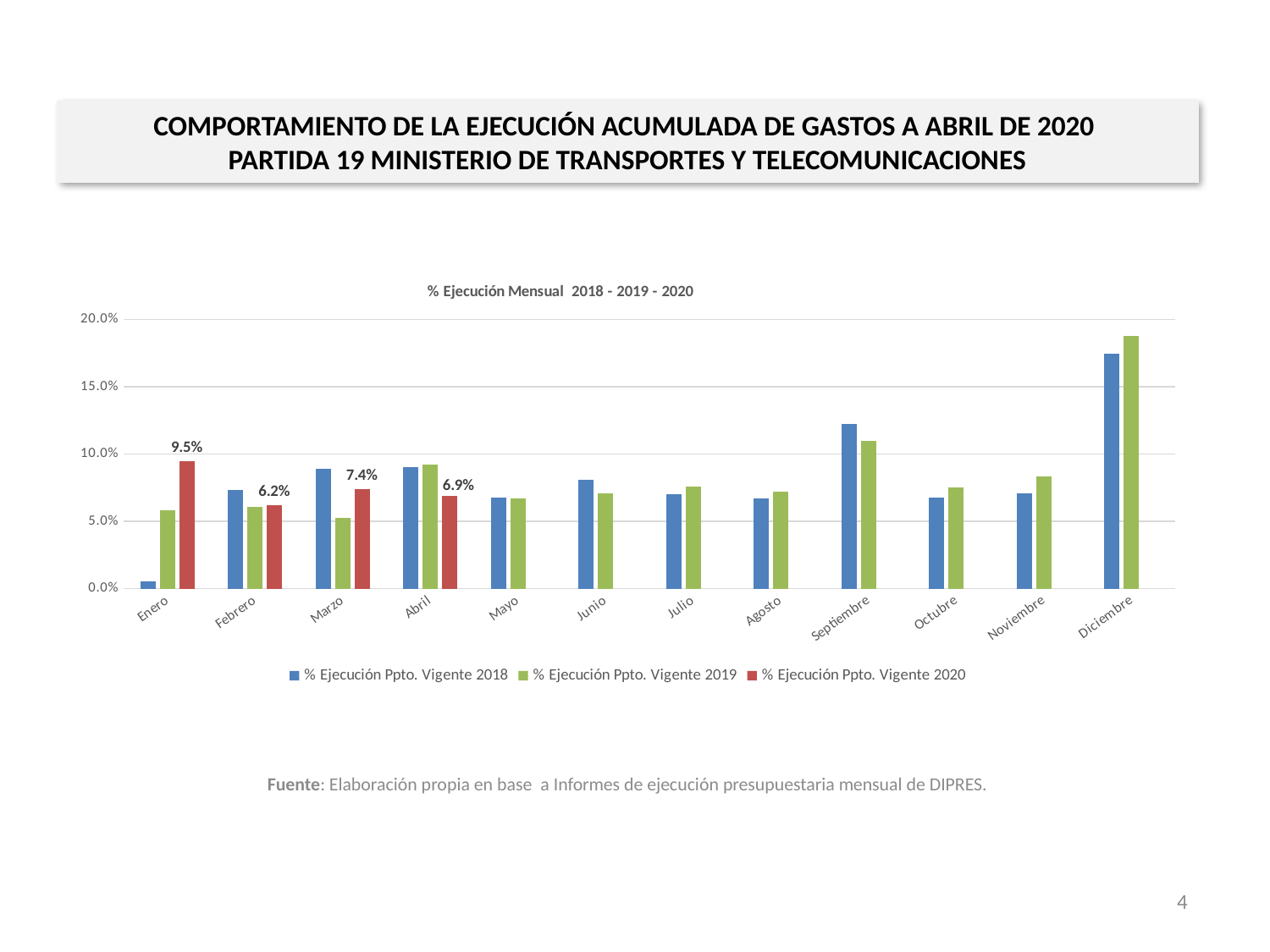
What is the value for Marzo in the % Ejecución Ppto. Vigente 2020 series? 7.4% In the % Ejecución Ppto. Vigente 2020 series, which is larger, the value for Marzo or the value for Abril? Marzo What is the value for Abril in the % Ejecución Ppto. Vigente 2020 series? 6.9% Which month has the lowest value in the % Ejecución Ppto. Vigente 2020 series? Febrero What is the value for Enero in the % Ejecución Ppto. Vigente 2020 series? 9.5% Is the value for Enero in the % Ejecución Ppto. Vigente 2018 series greater or less than 5.0%? less How many series does the chart legend list? 3 Which month has the highest value in the % Ejecución Ppto. Vigente 2020 series? Enero How many months are shown on the x axis of the chart? 12 Is the value for Diciembre in the % Ejecución Ppto. Vigente 2019 series greater or less than 15.0%? greater What kind of chart is shown on the slide? Bar chart What is the difference between the Enero and Febrero values in the % Ejecución Ppto. Vigente 2020 series? 3.3%